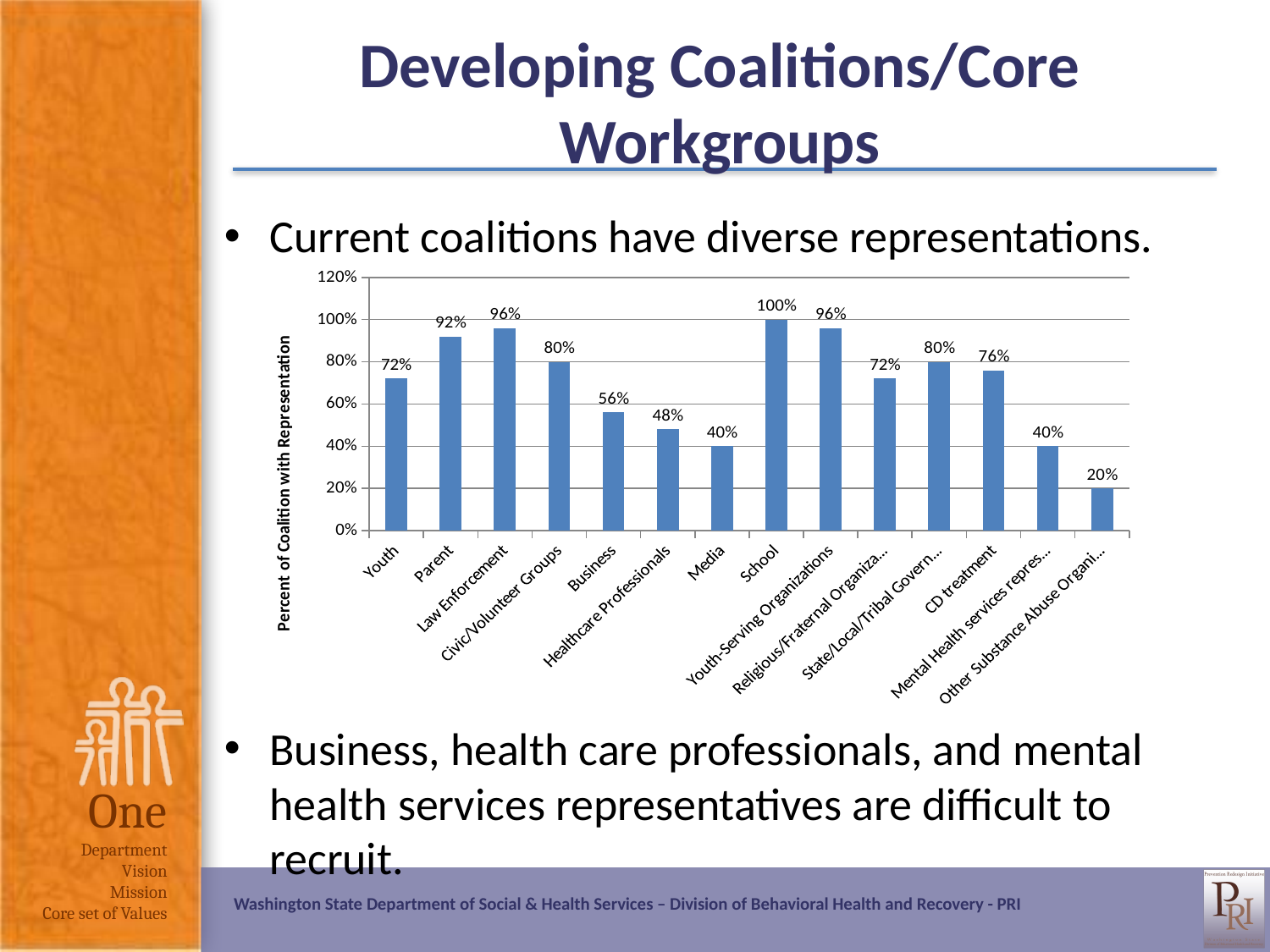
What is the value for Civic/Volunteer Groups? 80% What is the label of the vertical axis? Percent of Coalition with Representation Is the value for Law Enforcement greater or less than 80%? greater What is the value for School? 100% What kind of chart is shown on the slide? bar chart Which category has the highest value? School Which category has the lowest value? Other Substance Abuse Organi... What is the value for Healthcare Professionals? 48% What is the value for CD treatment? 76% Which is larger, the value for Youth or the value for Media? Youth What is the difference between the values for Parent and Business? 36% How many categories are shown on the x axis? 14